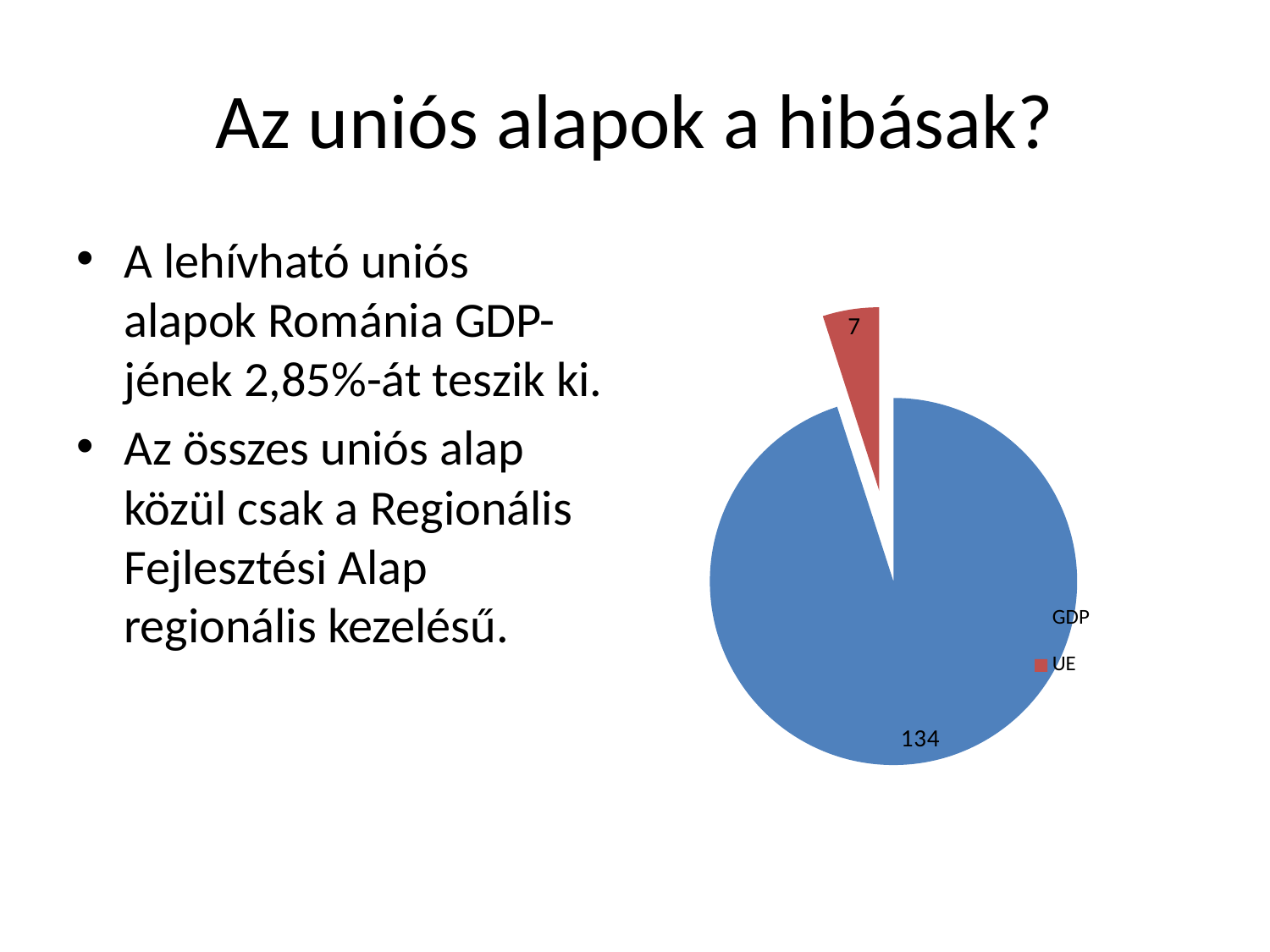
How many slices does the pie chart have? 2 Which slice of the pie chart is the largest? GDP What is the value shown for the GDP slice of the pie chart? 134 What colour is the GDP slice in the pie chart? blue What kind of chart is shown on the slide? pie chart Which is larger in the pie chart, GDP or UE? GDP Which slice of the pie chart is the smallest? UE What is the total of the two values shown in the pie chart? 141 What colour is the UE slice in the pie chart? red How many entries does the legend of the pie chart list? 2 What is the difference between the GDP value and the UE value in the pie chart? 127 What is the value shown for the UE slice of the pie chart? 7